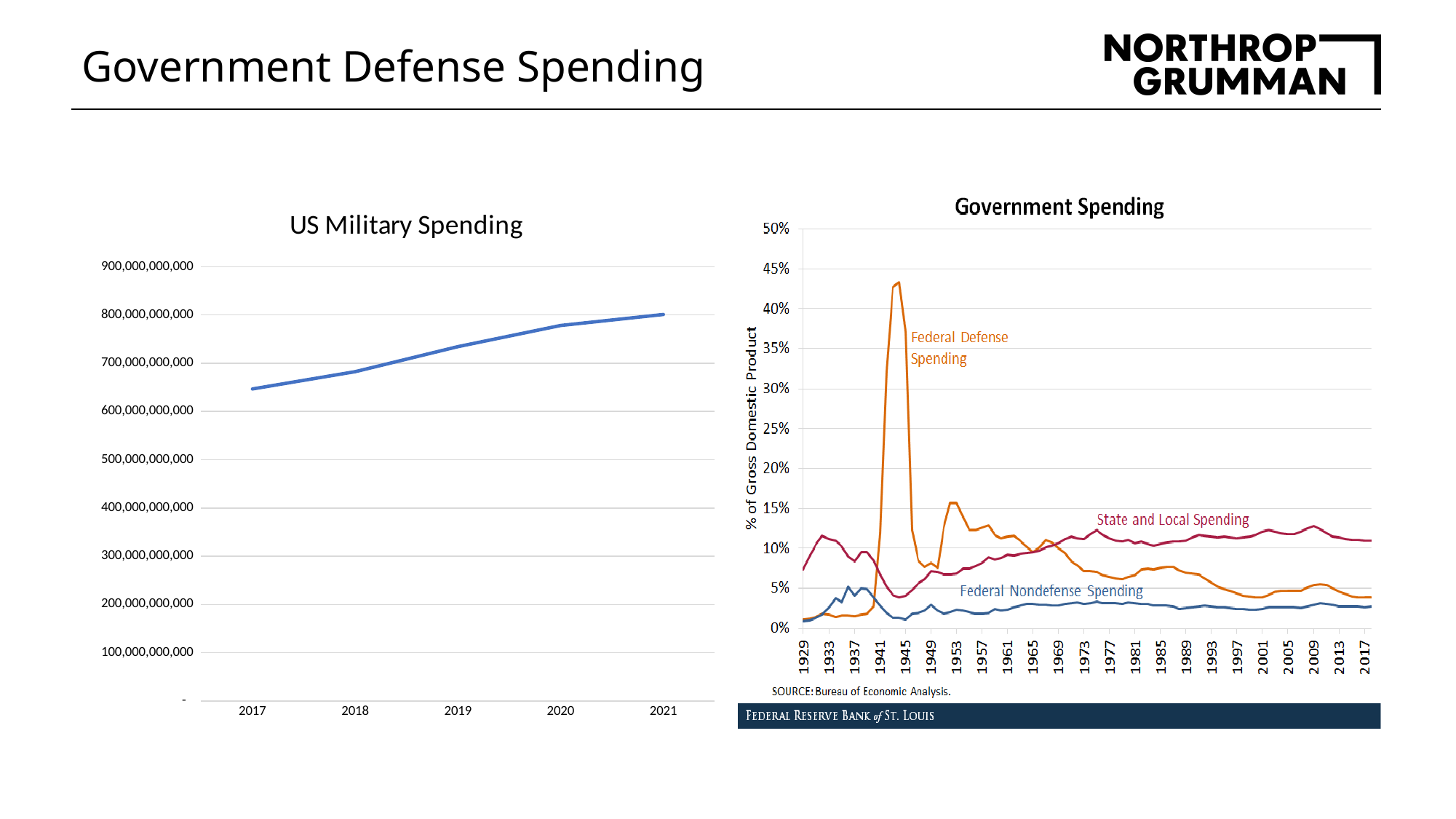
In the US Military Spending chart, which year has the highest value? 2021 In the US Military Spending chart, how many years are plotted on the x axis? 5 In the Government Spending chart, how many series are plotted? 3 In the Government Spending chart, is the peak value of Federal Defense Spending greater or less than 40%? greater What type of chart is the US Military Spending chart? line chart In the US Military Spending chart, which year has the lowest value? 2017 In the Government Spending chart, which series reaches the highest value? Federal Defense Spending What is the y-axis label of the Government Spending chart? % of Gross Domestic Product In the Government Spending chart, which is larger in 2017: State and Local Spending or Federal Defense Spending? State and Local Spending In the US Military Spending chart, is the value for 2020 greater or less than 700,000,000,000? greater In the US Military Spending chart, do the values rise or fall from 2017 to 2021? rise In the US Military Spending chart, is the value for 2017 greater or less than 700,000,000,000? less